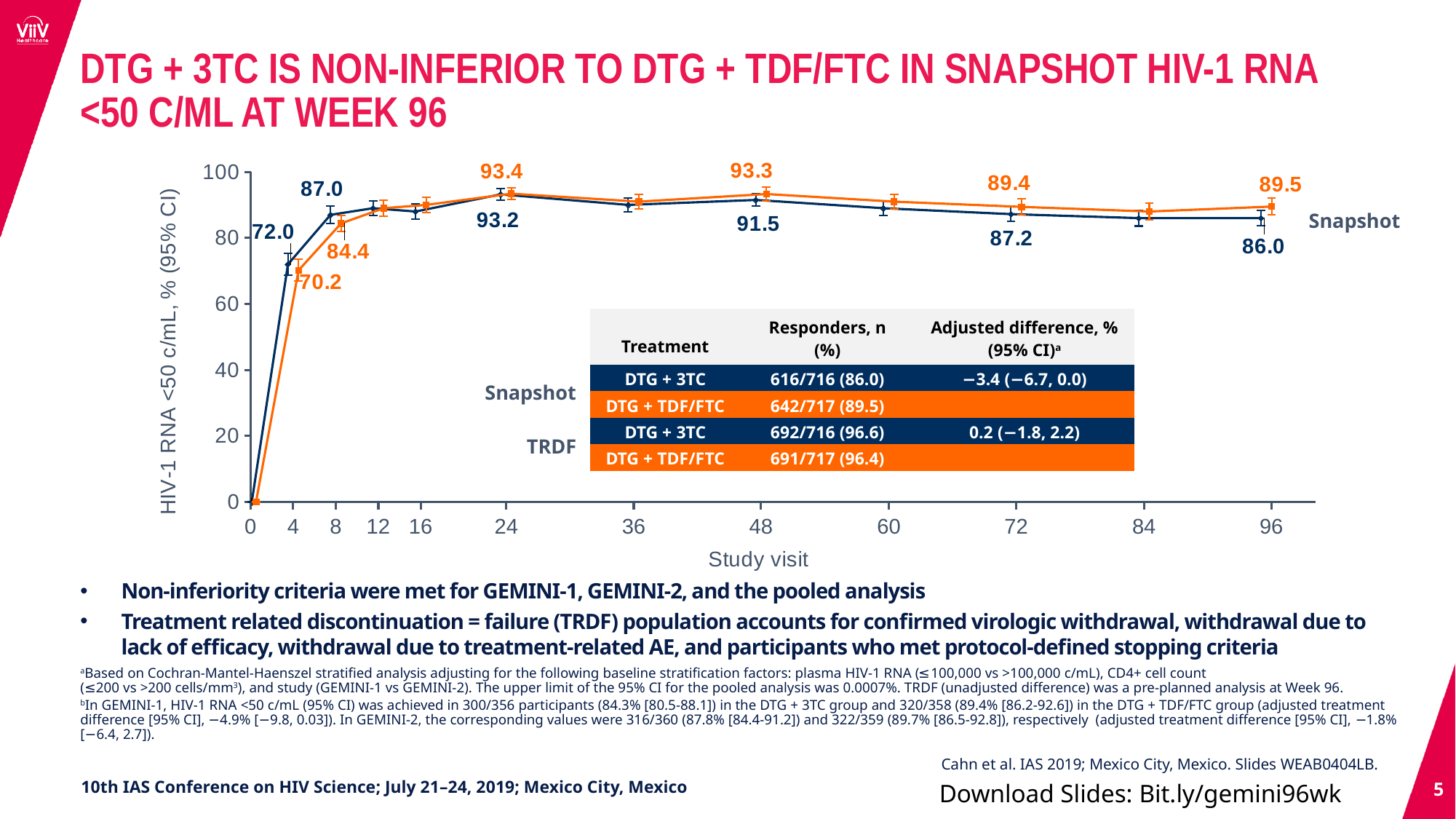
What is the label of the y axis? HIV-1 RNA <50 c/mL, % (95% CI) What is the value of the dark blue (DTG + 3TC) line at study visit week 96? 86.0 What type of chart is shown on the slide? line chart At which labelled study visit does the orange (DTG + TDF/FTC) line reach its highest labelled value? 24 What is the value of the orange (DTG + TDF/FTC) line at week 48? 93.3 At week 8, which line has the higher value, dark blue (DTG + 3TC) or orange (DTG + TDF/FTC)? dark blue (DTG + 3TC) What is the value of the orange (DTG + TDF/FTC) line at study visit week 96? 89.5 How many study visit time points are labelled on the x axis? 12 What is the difference between the orange (DTG + TDF/FTC) and dark blue (DTG + 3TC) values at week 96? 3.5 What is the value of the dark blue (DTG + 3TC) line at week 4? 72.0 What is the value of the dark blue (DTG + 3TC) line at week 72? 87.2 Is the value of the dark blue (DTG + 3TC) line at week 4 greater or less than 80? less